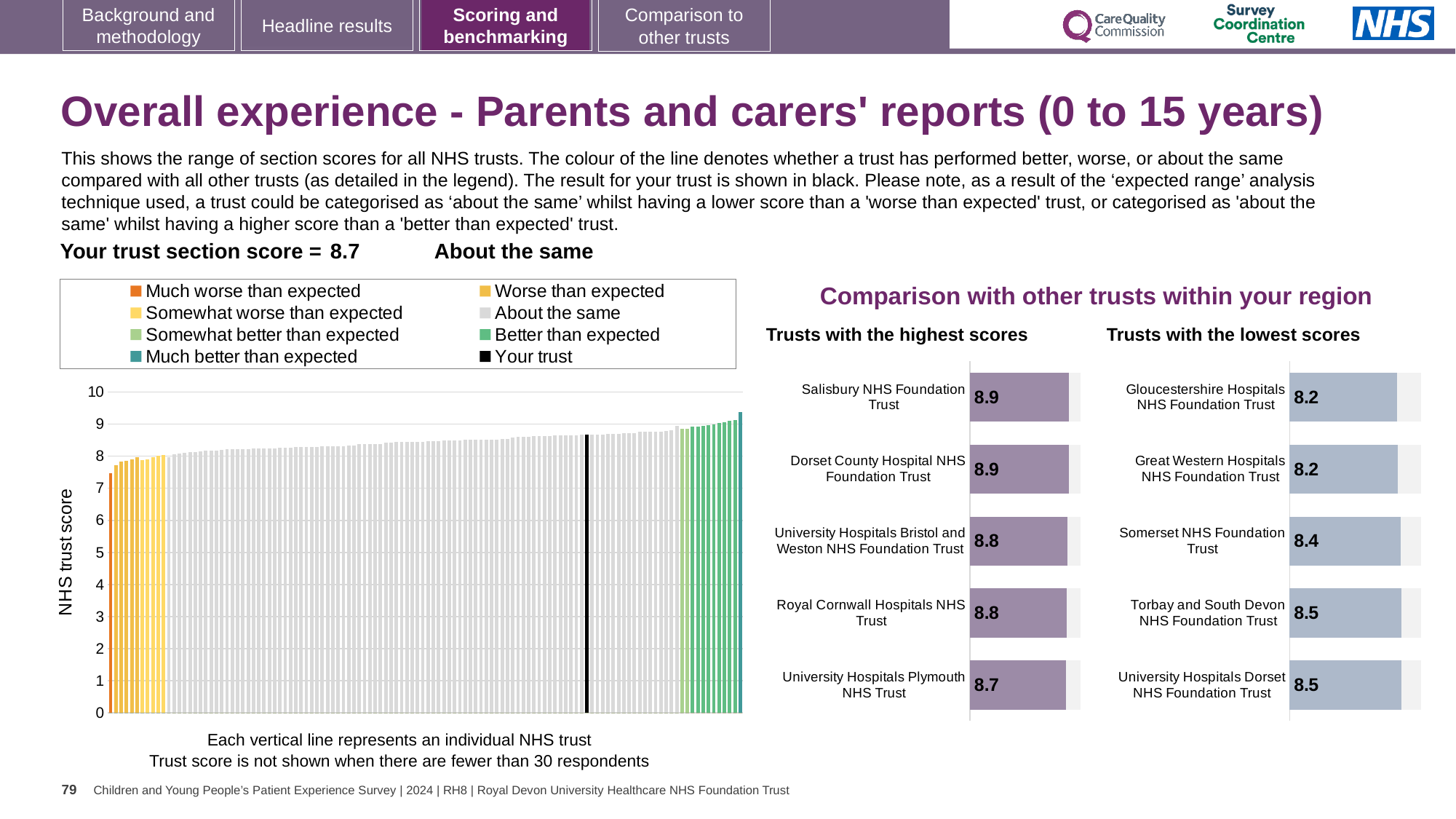
In the 'Trusts with the highest scores' chart, which trust has the lowest score? University Hospitals Plymouth NHS Trust In the 'Trusts with the lowest scores' chart, what is the difference between the scores of Somerset NHS Foundation Trust and Gloucestershire Hospitals NHS Foundation Trust? 0.2 In the large 'NHS trust score' chart on the left, is the value of the leftmost (orange) bar greater or less than 8? less In the 'Trusts with the lowest scores' chart, what is the score for Gloucestershire Hospitals NHS Foundation Trust? 8.2 In the 'Trusts with the highest scores' chart, how many trusts are shown? 5 In the 'Trusts with the highest scores' chart, what is the score for Salisbury NHS Foundation Trust? 8.9 In the 'Trusts with the lowest scores' chart, which is larger: the score for Torbay and South Devon NHS Foundation Trust or the score for Great Western Hospitals NHS Foundation Trust? Torbay and South Devon NHS Foundation Trust How many entries does the legend above the 'NHS trust score' chart list? 8 In the 'Trusts with the highest scores' chart, what is the score for University Hospitals Plymouth NHS Trust? 8.7 In the 'Trusts with the lowest scores' chart, what is the score for Somerset NHS Foundation Trust? 8.4 In the large 'NHS trust score' chart on the left, what kind of chart is it? Bar chart In the 'Trusts with the highest scores' chart, what is the difference between the scores of Salisbury NHS Foundation Trust and University Hospitals Plymouth NHS Trust? 0.2